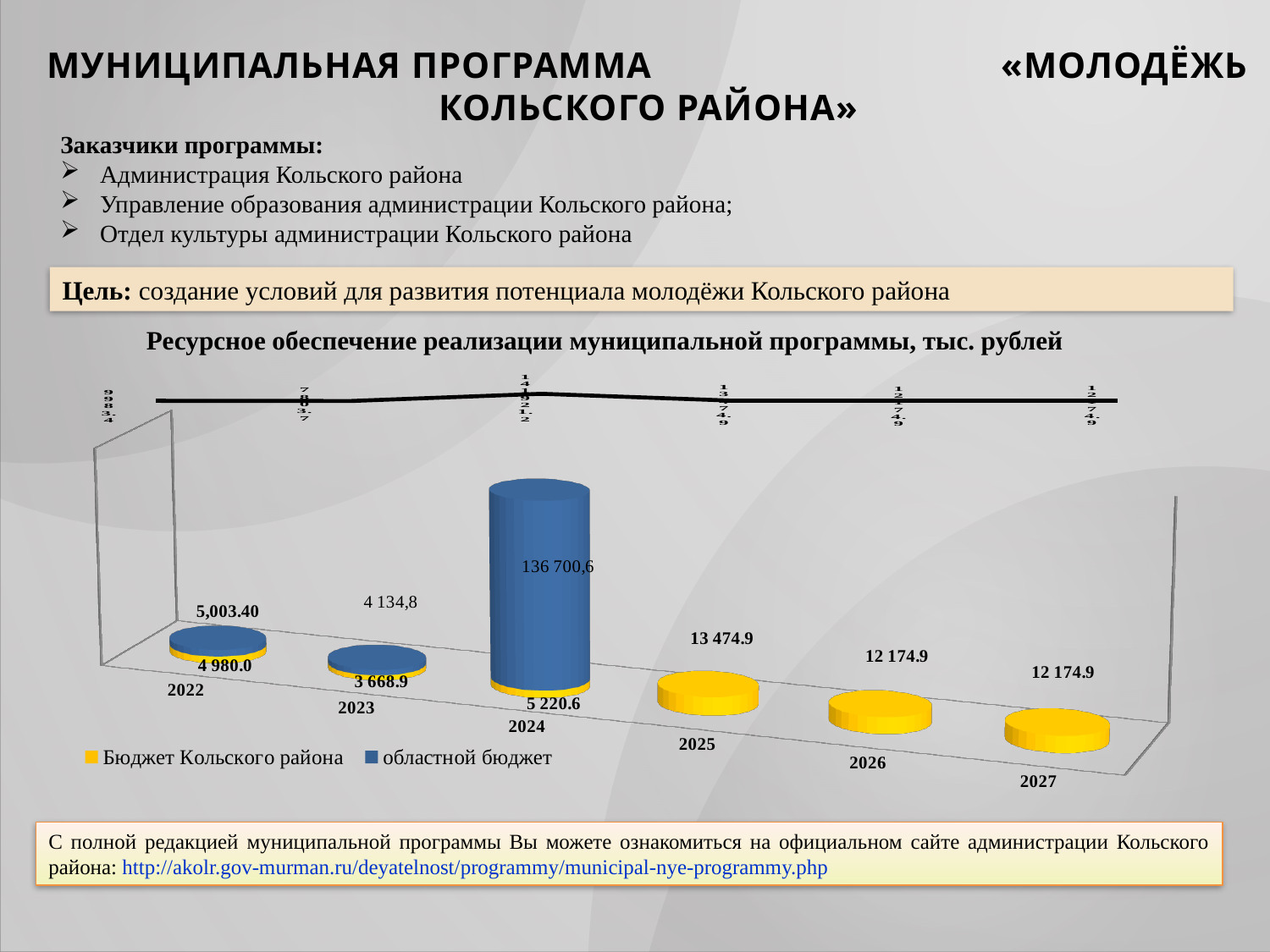
In which year is the Бюджет Кольского района value lowest? 2023 Which is larger in 2022: Бюджет Кольского района or областной бюджет? областной бюджет What is the value for Бюджет Кольского района in 2025? 13 474.9 In which year is the Бюджет Кольского района value highest? 2025 In which year is the областной бюджет value highest? 2024 What is the value for Бюджет Кольского района in 2023? 3 668.9 How many years are shown on the x axis of the chart? 6 What is the value for областной бюджет in 2022? 5,003.40 What is the value for областной бюджет in 2024? 136 700,6 What is the value for Бюджет Кольского района in 2027? 12 174.9 What is the difference between the Бюджет Кольского района values for 2025 and 2026? 1 300.0 How many series does the chart legend list? 2